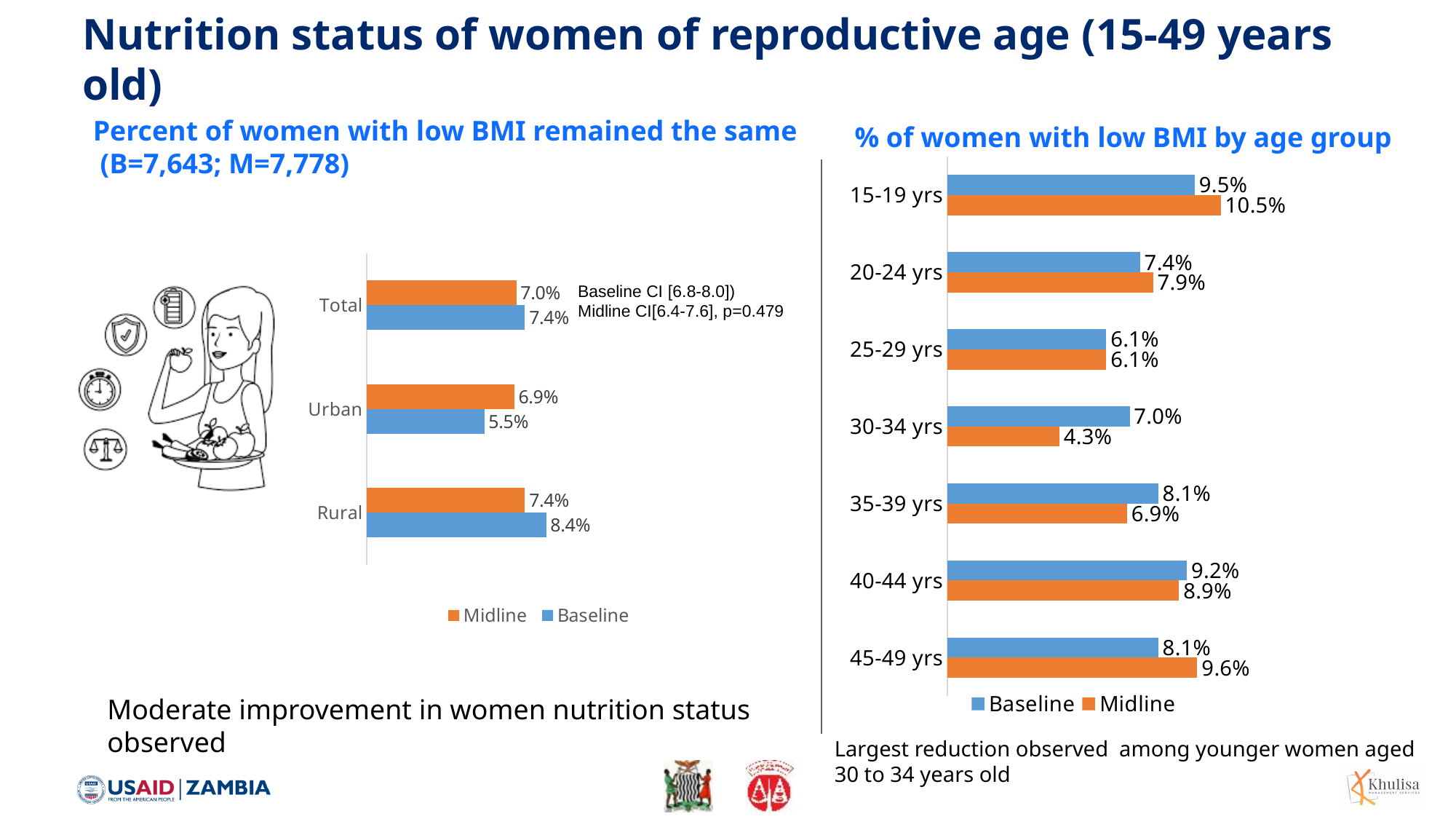
In the left chart 'Percent of women with low BMI remained the same', what is the Baseline value for Urban? 5.5% In the chart '% of women with low BMI by age group', what is the Midline value for the 15-19 yrs group? 10.5% In the left chart 'Percent of women with low BMI remained the same', what is the Midline value for Rural? 7.4% In the chart '% of women with low BMI by age group', is the Baseline or the Midline value larger for the 45-49 yrs group? Midline In the chart '% of women with low BMI by age group', how many age groups are shown? 7 How many series does the legend of the chart '% of women with low BMI by age group' list? 2 In the chart '% of women with low BMI by age group', which age group has the highest Midline value? 15-19 yrs In the chart '% of women with low BMI by age group', what is the difference between the Baseline and Midline values for the 30-34 yrs group? 2.7% In the left chart 'Percent of women with low BMI remained the same', what is the difference between the Baseline and Midline values for Rural? 1.0% What type of chart is the left chart 'Percent of women with low BMI remained the same'? Bar chart In the chart '% of women with low BMI by age group', what is the Baseline value for the 30-34 yrs group? 7.0% In the chart '% of women with low BMI by age group', which age group has the lowest Midline value? 30-34 yrs